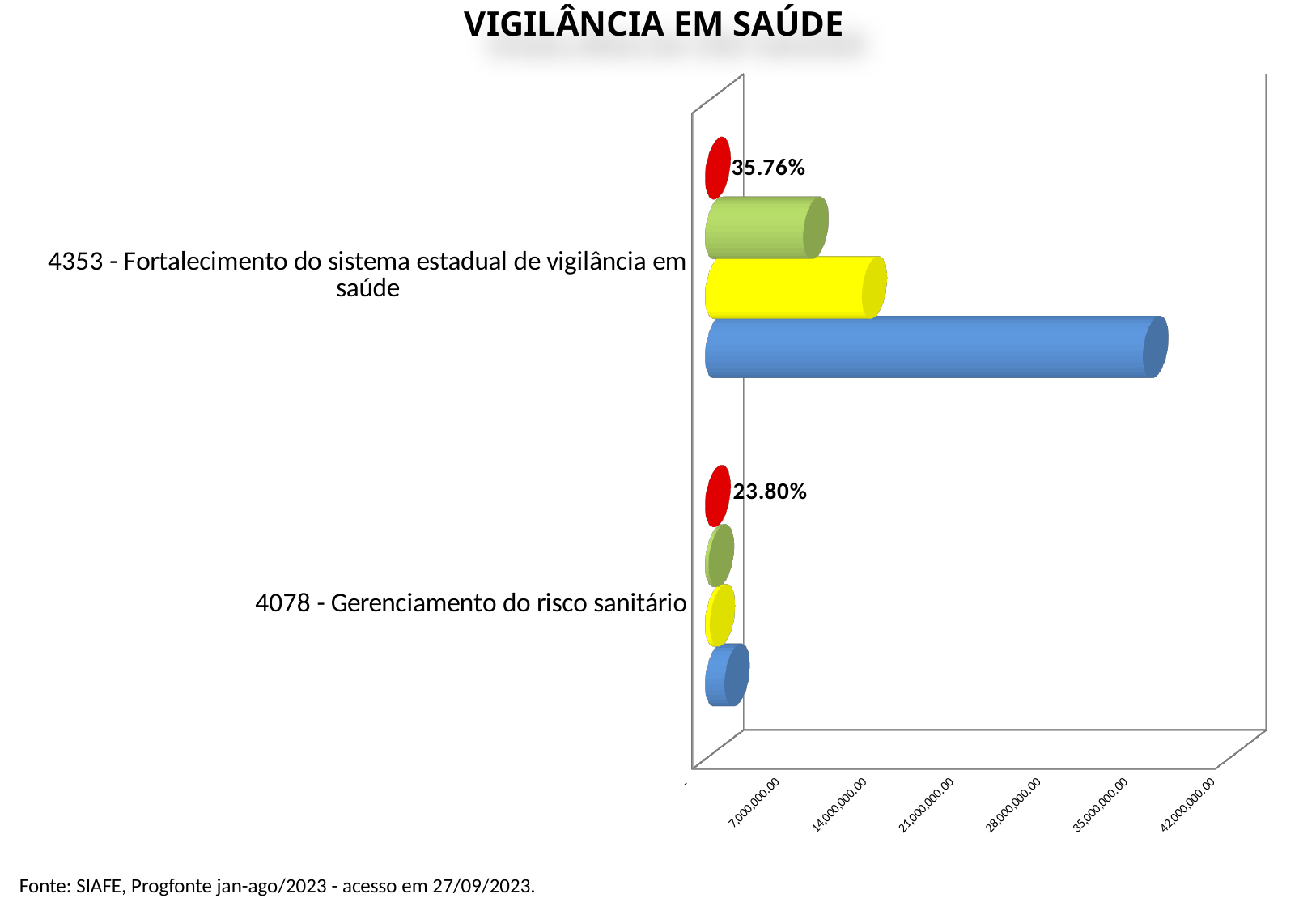
What is the highest value shown on the horizontal axis? 42,000,000.00 What is the difference in percentage points between the labels for 4353 (35.76%) and 4078 (23.80%)? 11.96 Is the value of the yellow bar for '4353 - Fortalecimento do sistema estadual de vigilância em saúde' greater or less than 7,000,000.00? greater Which category has the longest blue bar? 4353 - Fortalecimento do sistema estadual de vigilância em saúde Which category has the higher percentage label, 4353 or 4078? 4353 - Fortalecimento do sistema estadual de vigilância em saúde Is the value of the blue bar for '4353 - Fortalecimento do sistema estadual de vigilância em saúde' greater or less than 28,000,000.00? greater What kind of chart is shown on the slide? Bar chart How many categories (programs) are shown on the chart? 2 What percentage is labelled for '4078 - Gerenciamento do risco sanitário'? 23.80% What is the title of the chart? VIGILÂNCIA EM SAÚDE What percentage is labelled for '4353 - Fortalecimento do sistema estadual de vigilância em saúde'? 35.76% Is the value of the blue bar for '4078 - Gerenciamento do risco sanitário' greater or less than 7,000,000.00? less